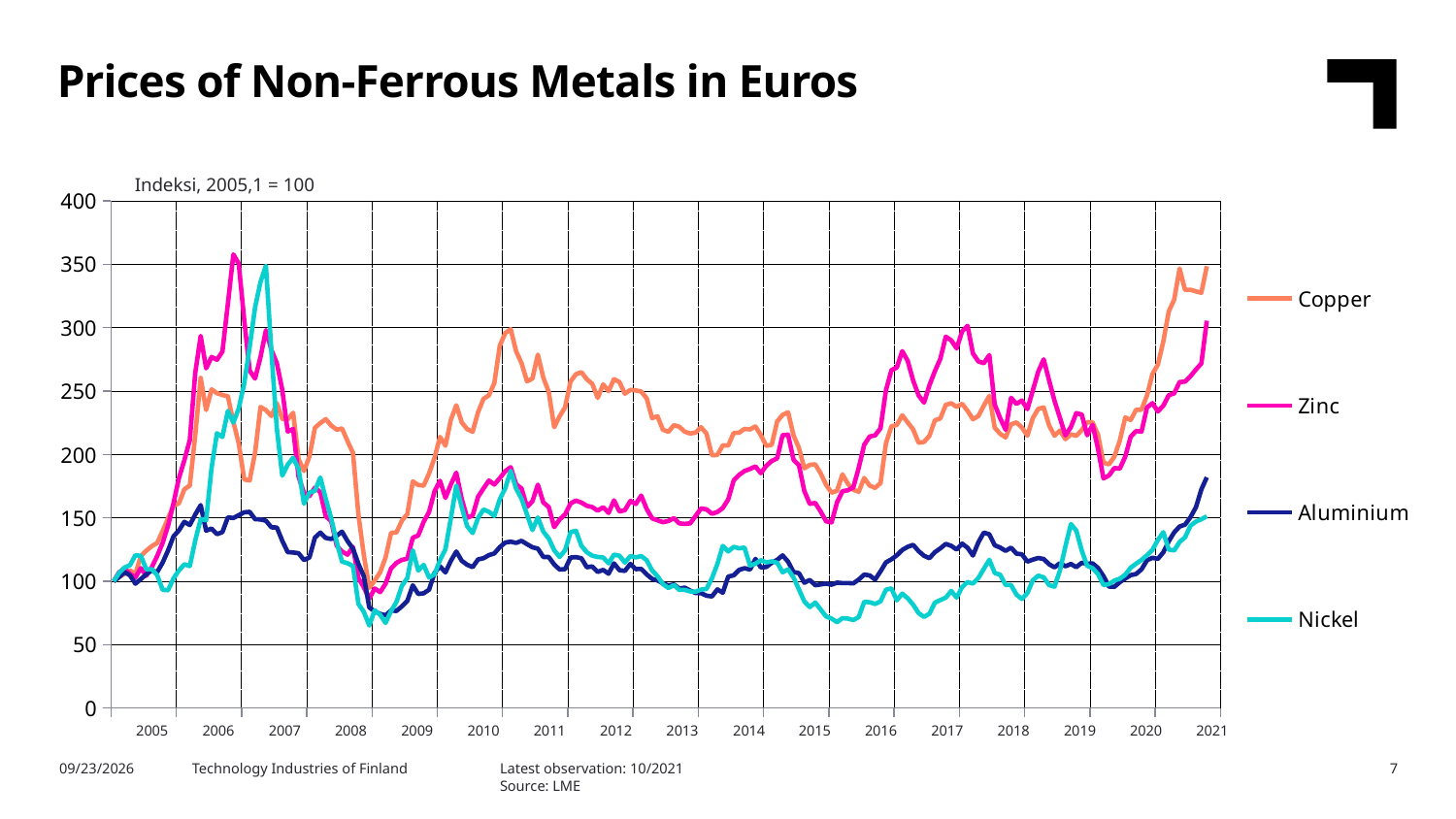
What kind of chart is shown on the slide? Line chart What is the index base stated above the chart? Indeksi, 2005,1 = 100 How many series does the legend list? 4 Is the value for Copper at the end of 2021 greater or less than 300? greater Which series has the highest value at the end of the chart in 2021? Copper Does the Copper series rise or fall from 2019 to 2021? Rise Is the peak value for Zinc in 2006 greater or less than 300? greater Which series has the lowest value at the end of the chart in 2021? Nickel Which metals are listed in the legend? Copper, Zinc, Aluminium, Nickel Is the lowest value for Nickel around 2015 greater or less than 100? less In 2015, which is larger, the value for Aluminium or the value for Nickel? Aluminium